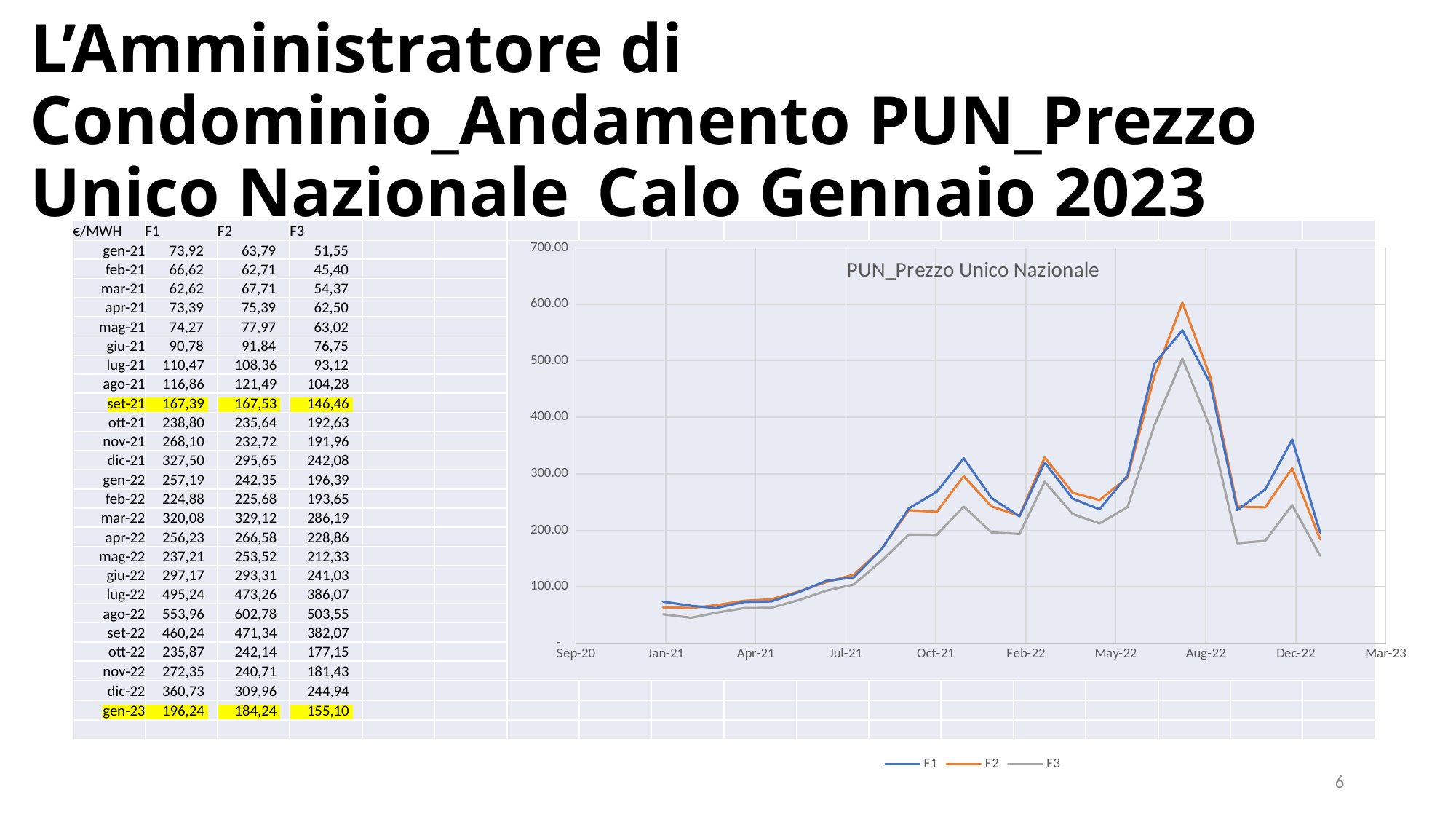
In which month does F1 reach its highest value? ago-22 What kind of chart is shown on the slide? line chart Do the F1 values rise or fall from Aug-22 to Oct-22? fall What is the difference between the F1 and F2 values for gen-23? 12,00 In which month does F3 reach its lowest value? feb-21 Is the F3 value at Aug-22 greater or less than 400? greater What is the F2 value for ago-22? 602,78 How many series does the chart legend list? 3 What is the title shown inside the chart? PUN_Prezzo Unico Nazionale Which is larger in dic-22, F1 or F2? F1 By how much did F1 fall from dic-22 to gen-23? 164,49 What is the F3 value for set-21? 146,46